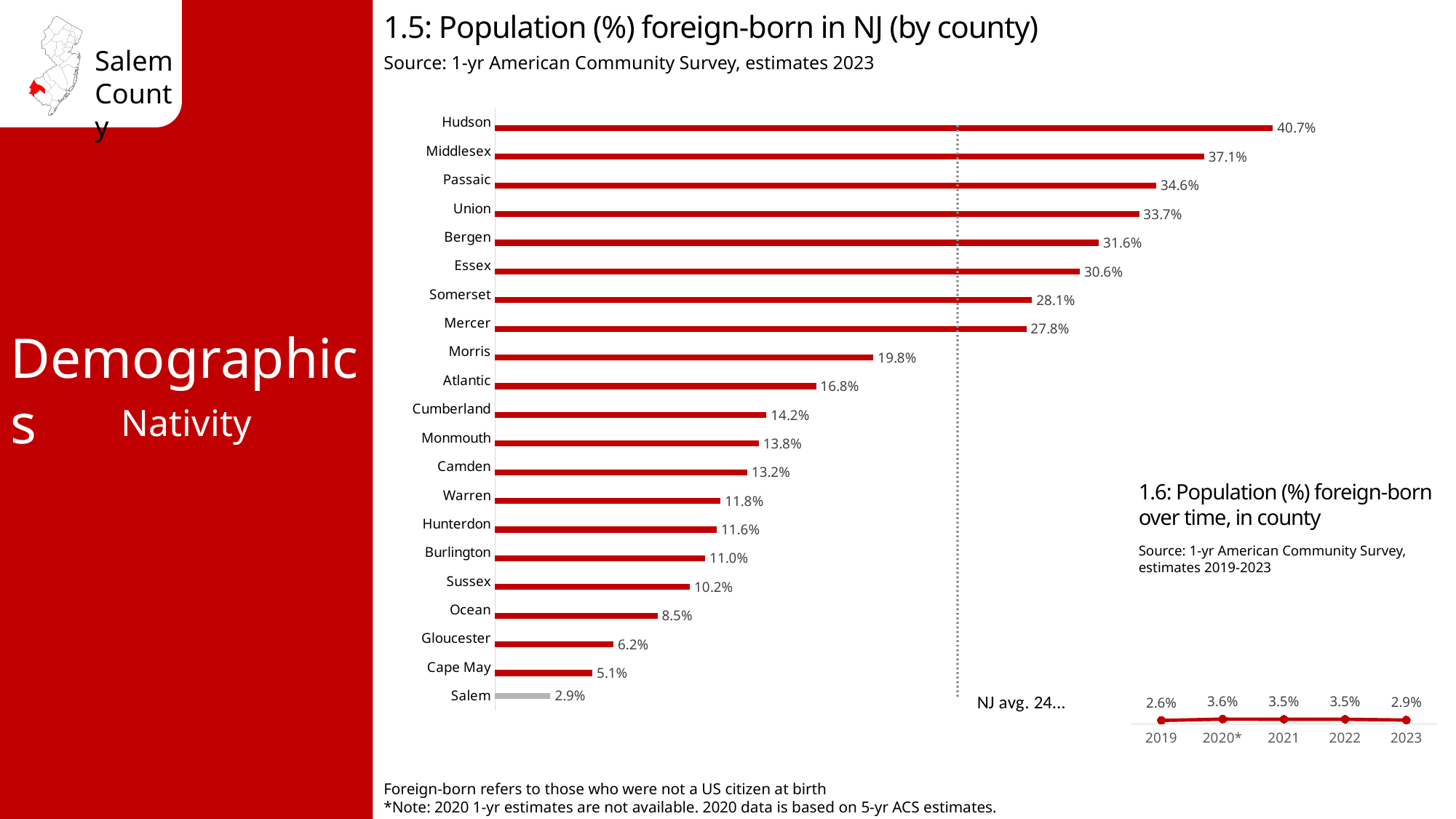
In chart 1.5 (Population (%) foreign-born in NJ by county), which is larger, Cumberland or Monmouth? Cumberland In chart 1.5 (Population (%) foreign-born in NJ by county), how many counties are shown? 21 What kind of chart is chart 1.5 (Population (%) foreign-born in NJ by county)? Bar chart In chart 1.5 (Population (%) foreign-born in NJ by county), which county has the lowest value? Salem In chart 1.6 (Population (%) foreign-born over time, in county), how many data points are plotted? 5 In chart 1.6 (Population (%) foreign-born over time, in county), which year has the lowest value? 2019 In chart 1.5 (Population (%) foreign-born in NJ by county), what is the value for Hudson? 40.7% In chart 1.6 (Population (%) foreign-born over time, in county), what is the value for 2021? 3.5% What kind of chart is chart 1.6 (Population (%) foreign-born over time, in county)? Line chart In chart 1.5 (Population (%) foreign-born in NJ by county), what is the difference between Middlesex and Passaic? 2.5% In chart 1.5 (Population (%) foreign-born in NJ by county), which county has the highest value? Hudson In chart 1.5 (Population (%) foreign-born in NJ by county), what is the value for Salem? 2.9%